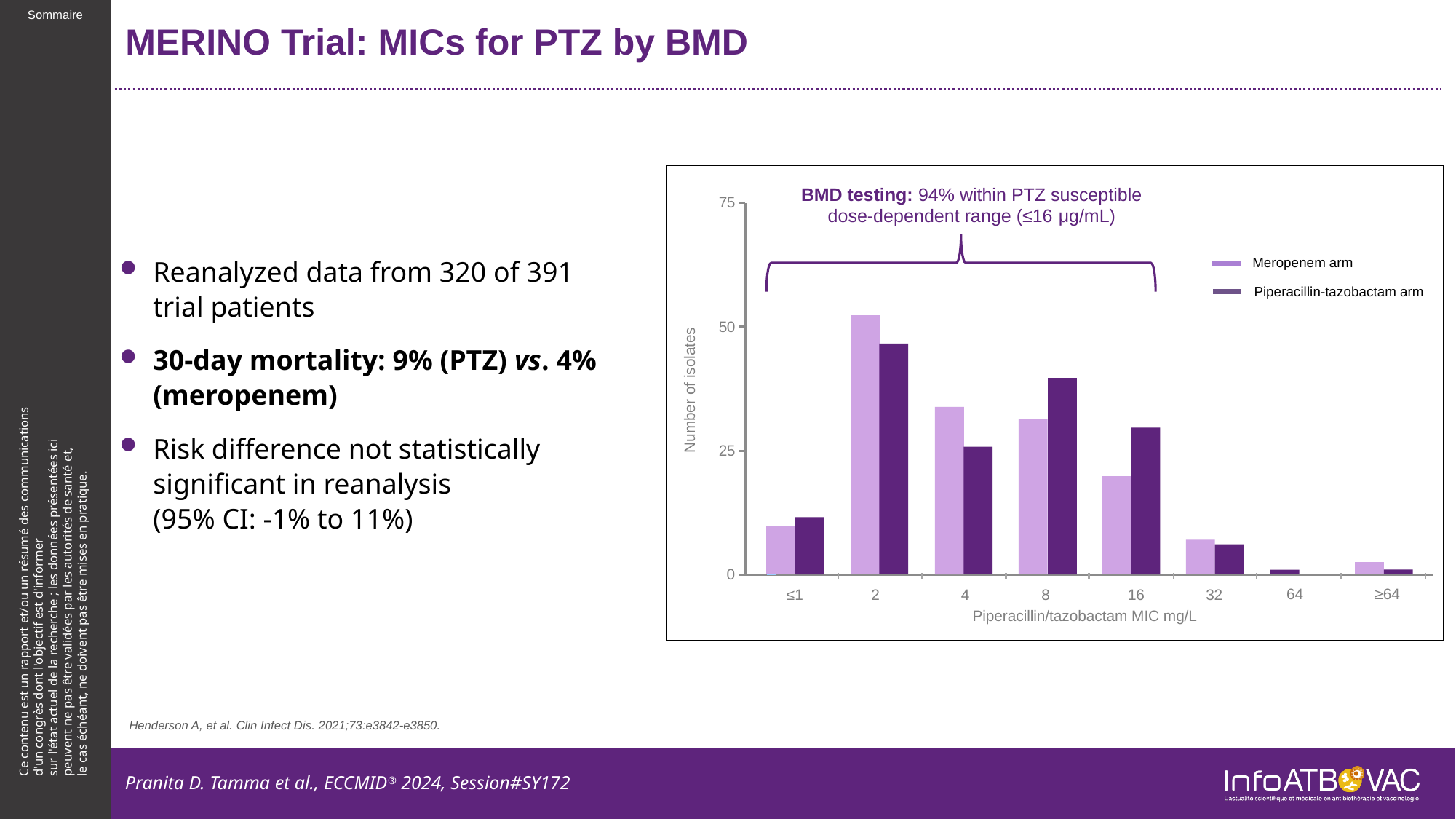
At MIC 8, which arm has more isolates? Piperacillin-tazobactam arm Is the number of isolates for the Piperacillin-tazobactam arm at MIC 8 greater or less than 50? less At which MIC value does the Meropenem arm have the highest number of isolates? 2 How many MIC categories are shown on the x axis of the chart? 8 Is the number of isolates for the Meropenem arm at MIC 4 greater or less than 25? greater What is the label of the x axis of the chart? Piperacillin/tazobactam MIC mg/L At which MIC value does the Meropenem arm have the lowest number of isolates? 64 What kind of chart is shown on the slide? bar chart At which MIC value does the Piperacillin-tazobactam arm have the highest number of isolates? 2 Is the number of isolates for the Meropenem arm at MIC 16 greater or less than 25? less At MIC 4, which arm has more isolates? Meropenem arm How many series does the chart legend list? 2